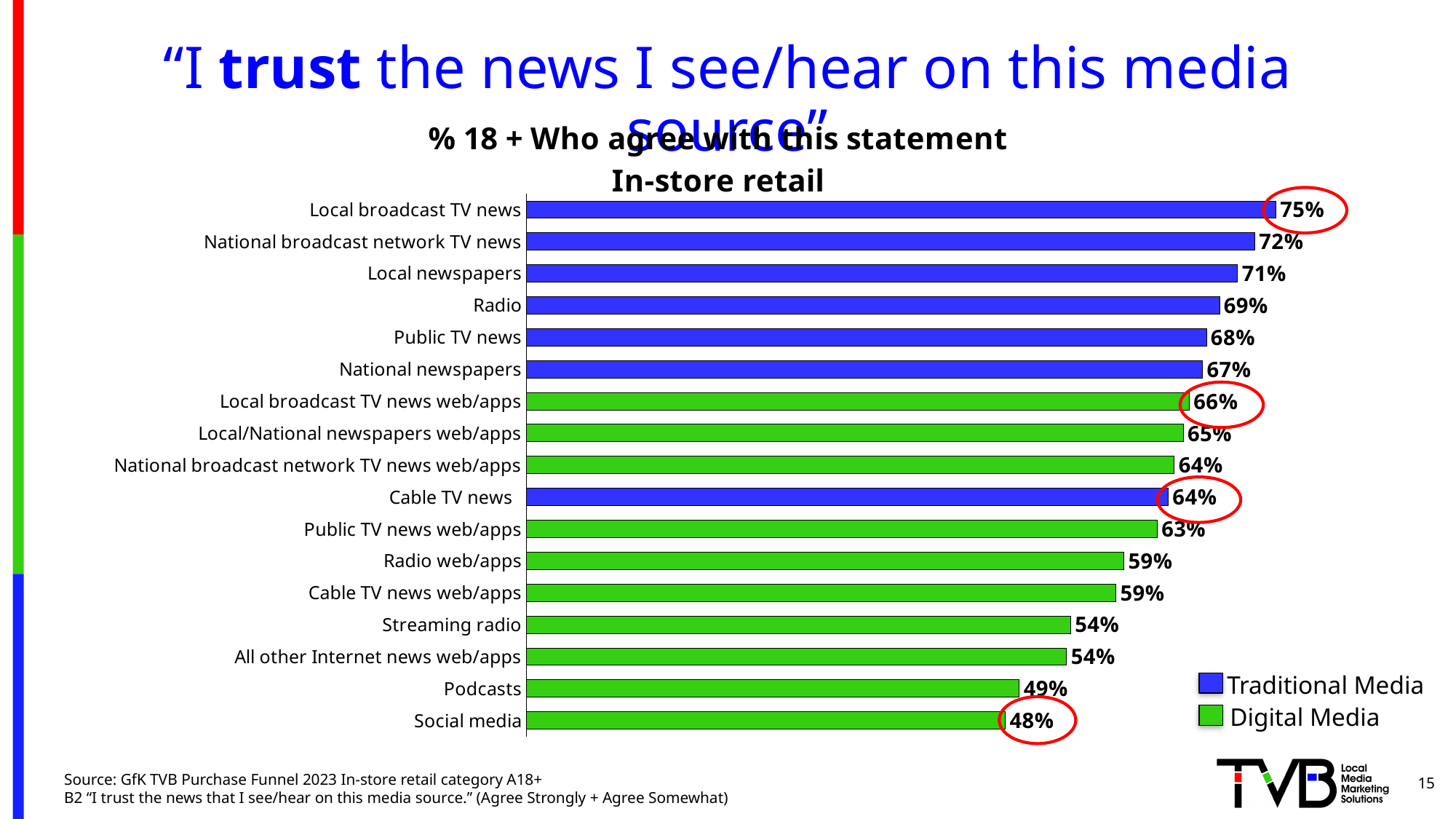
What is the value shown for Social media? 48% What is the difference in percentage points between Local broadcast TV news and Social media? 27 Which media source has the lowest percentage of agreement? Social media What is the difference in percentage points between Local broadcast TV news and Local broadcast TV news web/apps? 9 How many media sources are plotted in the chart? 17 What is the value shown for Cable TV news? 64% How many series does the legend list? 2 Which has a higher value, Radio or Radio web/apps? Radio What percentage of adults 18+ agree they trust the news on Local broadcast TV news? 75% What is the value shown for Podcasts? 49% Which media source has the highest percentage of agreement? Local broadcast TV news What type of chart is shown on the slide? Bar chart